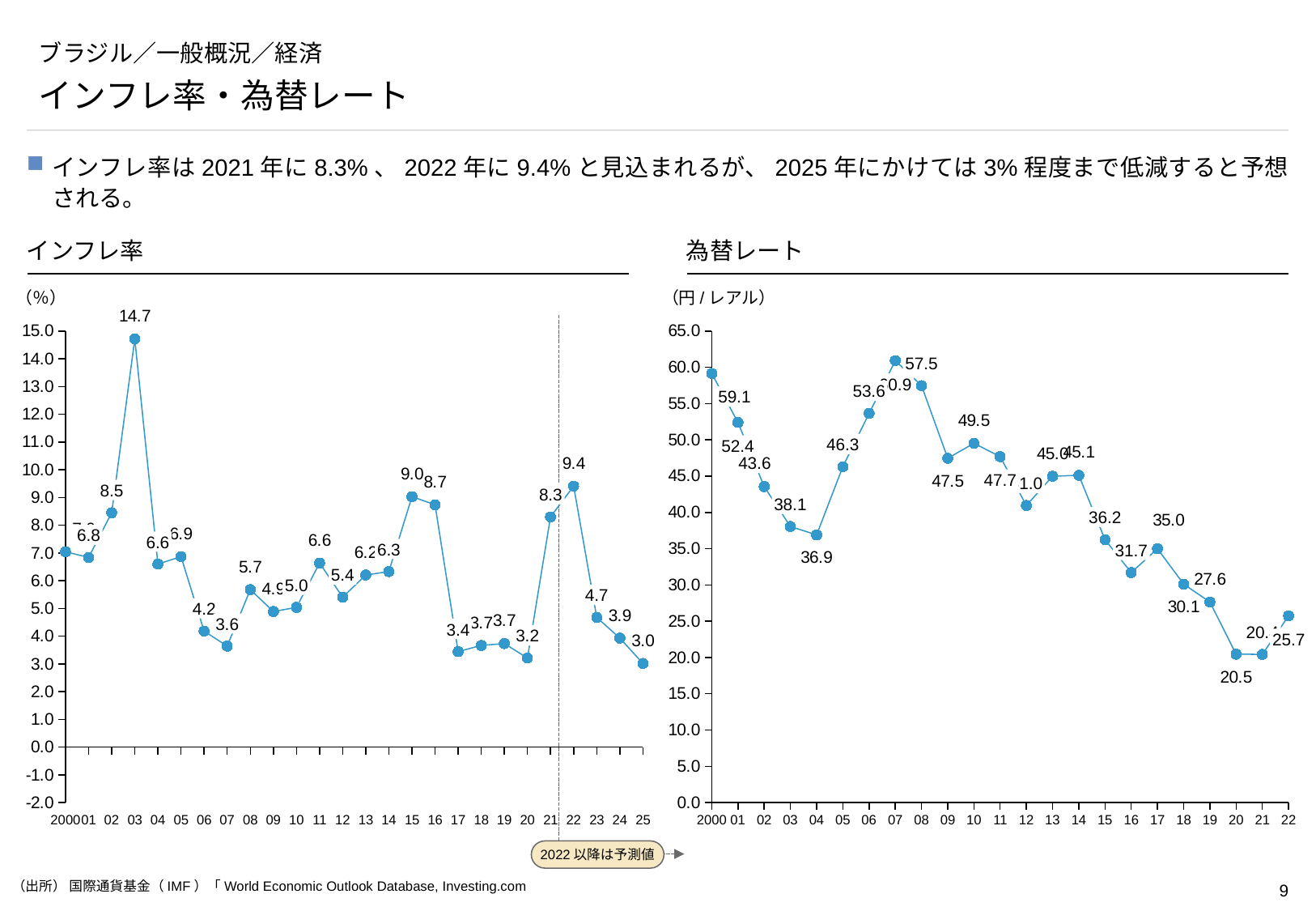
What unit is shown for the 為替レート chart? 円/レアル In the インフレ率 chart, which is larger, the value for 2015 or the value for 2016? 2015 In the インフレ率 chart, what is the inflation rate for 2003? 14.7 In the 為替レート chart, what is the value for 2000? 59.1 What kind of chart is the インフレ率 chart? line chart In the インフレ率 chart, which year has the highest inflation rate? 2003 In the 為替レート chart, which year has the highest value? 2007 In the 為替レート chart, what is the difference between the 2000 value and the 2022 value? 33.4 In the 為替レート chart, do the values rise or fall from 2014 to 2020? fall In the インフレ率 chart, which year has the lowest inflation rate? 2025 In the 為替レート chart, is the value for 2021 greater or less than 25.0? less In the インフレ率 chart, what is the difference between the 2022 value and the 2021 value? 1.1